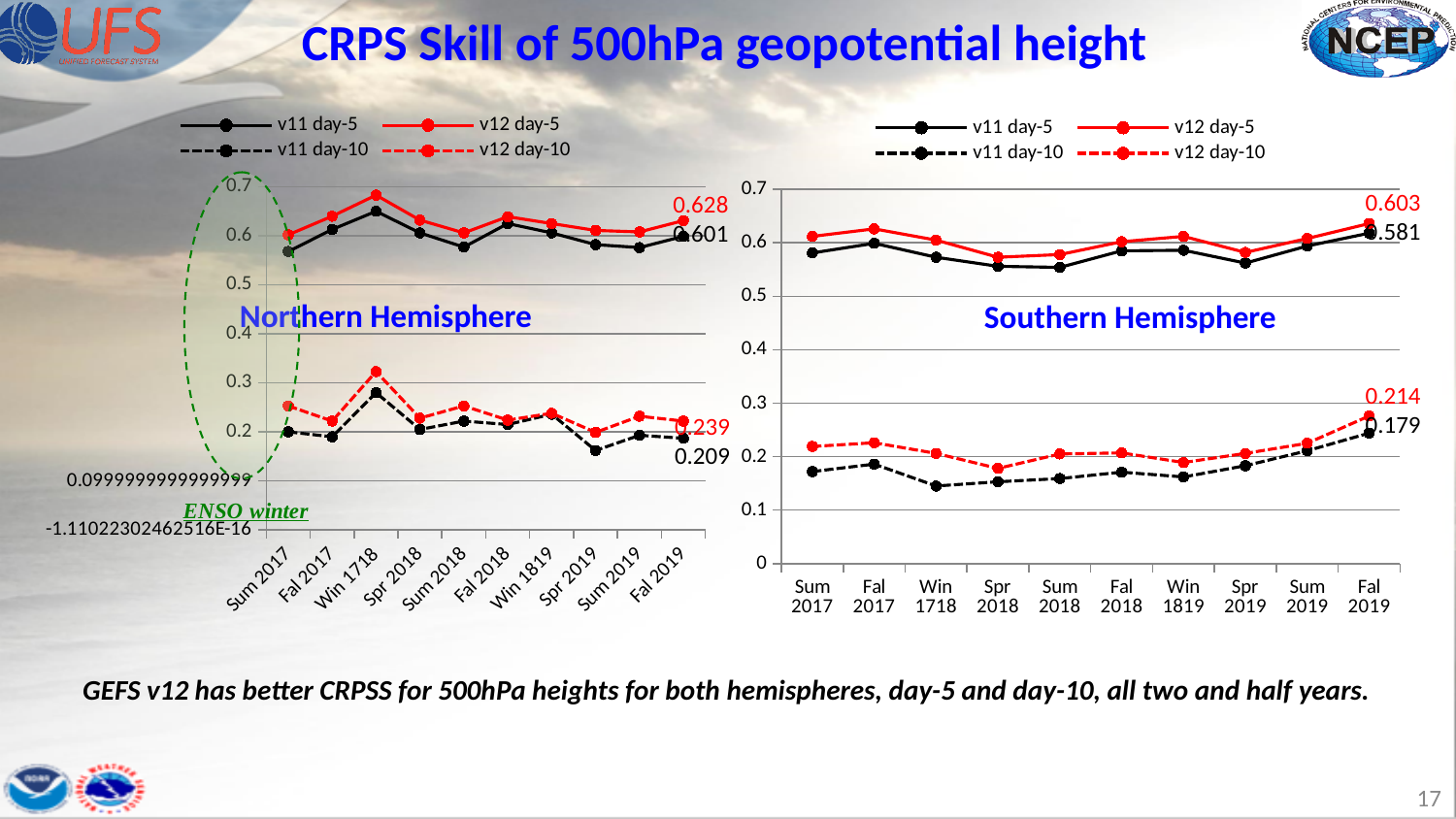
On the Northern Hemisphere chart, what is the labelled value for v11 day-10 at Fal 2019? 0.209 On the Northern Hemisphere chart, what is the labelled value for v12 day-5 at Fal 2019? 0.628 On the Southern Hemisphere chart, what is the labelled value for v11 day-10 at Fal 2019? 0.179 What kind of chart is the Southern Hemisphere chart? Line chart On the Northern Hemisphere chart, which is larger at Fal 2019: v12 day-5 or v11 day-5? v12 day-5 On the Southern Hemisphere chart, is the v11 day-5 value at Sum 2017 greater or less than 0.6? less How many seasons are plotted along the x axis of the Northern Hemisphere chart? 10 On the Southern Hemisphere chart, what is the labelled value for v12 day-5 at Fal 2019? 0.603 How many series does the legend of the Southern Hemisphere chart list? 4 On the Northern Hemisphere chart, at which season does the v12 day-5 series reach its highest value? Win 1718